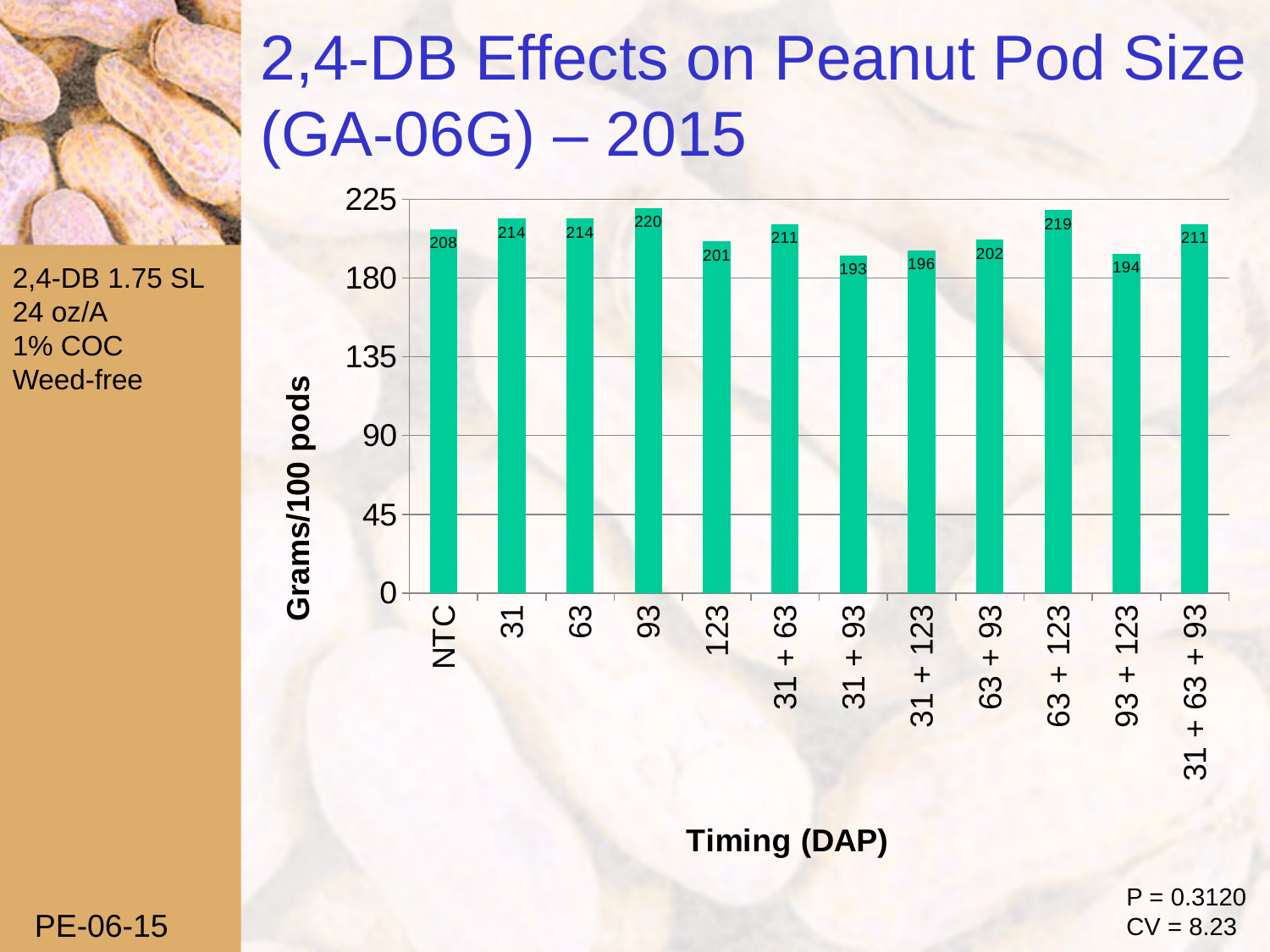
What is the value for NTC? 208 Which is larger, the value for 123 or the value for 31 + 63? 31 + 63 What is the value for the 31 + 93 timing? 193 What is the value for the 63 + 123 timing? 219 How many timing categories are shown on the x axis? 12 What is the x-axis label of the chart? Timing (DAP) Is the value for 93 + 123 greater or less than 180? greater What kind of chart is shown? bar chart What is the y-axis label of the chart? Grams/100 pods Which timing has the highest grams per 100 pods? 93 Which timing has the lowest grams per 100 pods? 31 + 93 What is the difference between the values for 93 and 31 + 93? 27